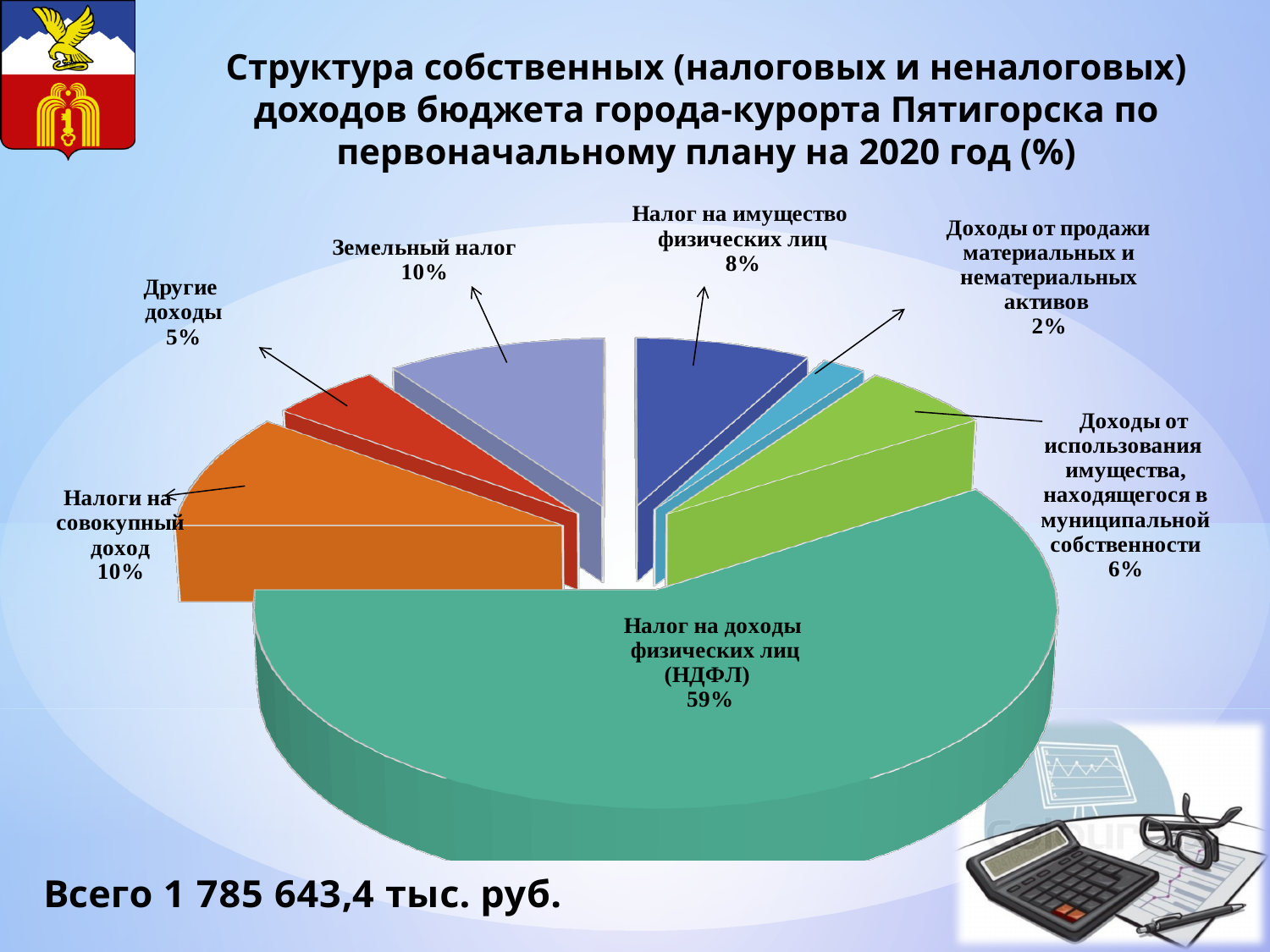
How many slices does the pie chart have? 7 What is the value shown for "Доходы от использования имущества, находящегося в муниципальной собственности"? 6% What share of the pie does "Налог на доходы физических лиц (НДФЛ)" have? 59% What is the value shown for "Доходы от продажи материальных и нематериальных активов"? 2% Which category has the smallest share of the pie? Доходы от продажи материальных и нематериальных активов What is the value shown for "Земельный налог"? 10% What is the value shown for "Налог на имущество физических лиц"? 8% Which is larger: "Доходы от использования имущества, находящегося в муниципальной собственности" or "Налог на имущество физических лиц"? Налог на имущество физических лиц Which category has the largest share of the pie? Налог на доходы физических лиц (НДФЛ) What kind of chart is shown on the slide? Pie chart What is the value shown for "Другие доходы"? 5% What is the difference in percentage points between "Налог на имущество физических лиц" and "Другие доходы"? 3